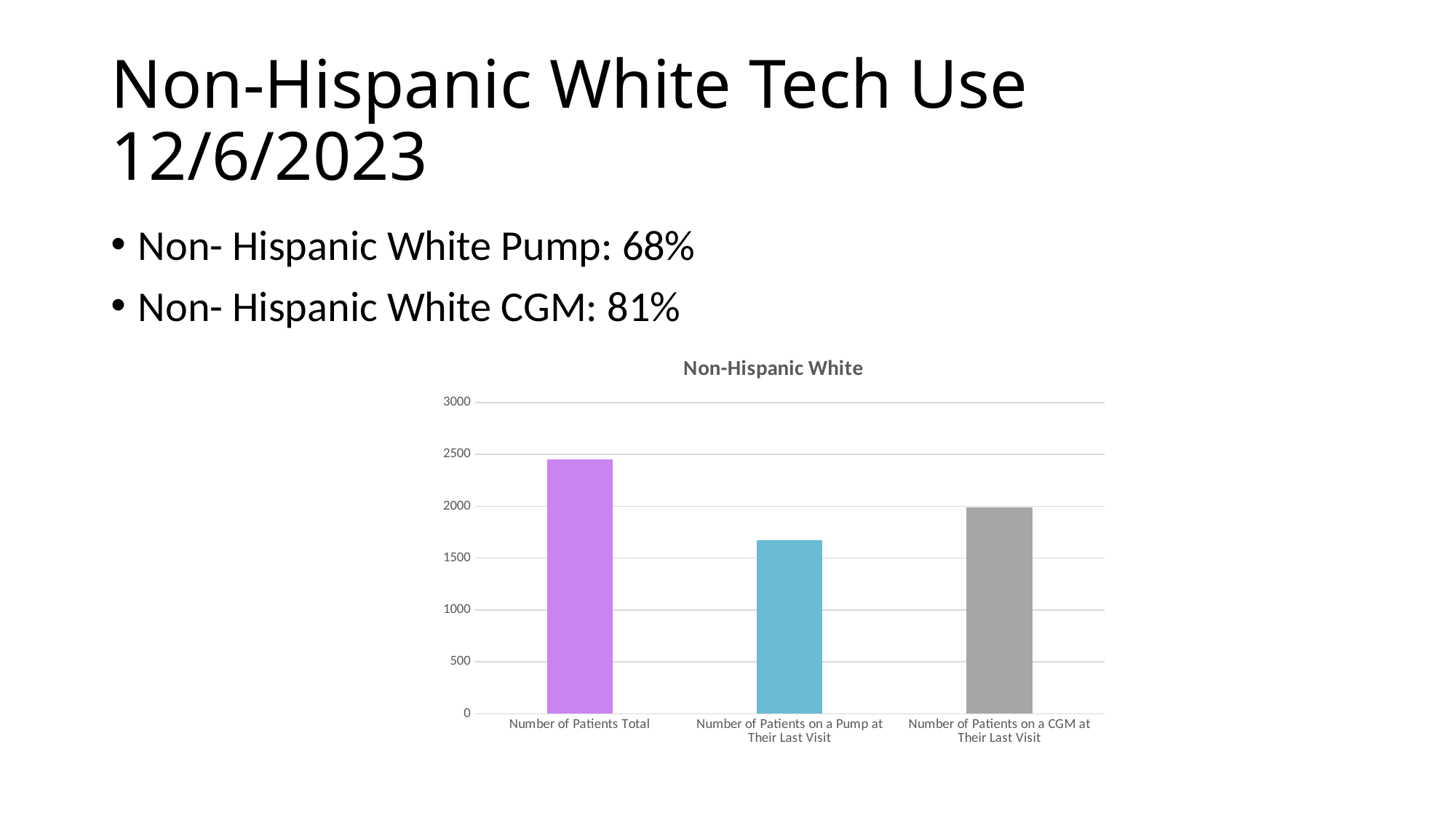
Which category has the lowest bar in the chart? Number of Patients on a Pump at Their Last Visit Is the value for Number of Patients on a Pump at Their Last Visit greater or less than 1500? greater Which category has the highest bar in the chart? Number of Patients Total Which is larger: the number of patients on a CGM at their last visit or the number of patients on a pump at their last visit? Number of Patients on a CGM at Their Last Visit Is the value for Number of Patients on a Pump at Their Last Visit greater or less than 2000? less What colour is the bar for Number of Patients on a Pump at Their Last Visit? Blue Is the value for Number of Patients Total greater or less than 2000? greater What kind of chart is shown on the slide? Bar chart How many categories are plotted in the chart? 3 What is the title of the chart? Non-Hispanic White